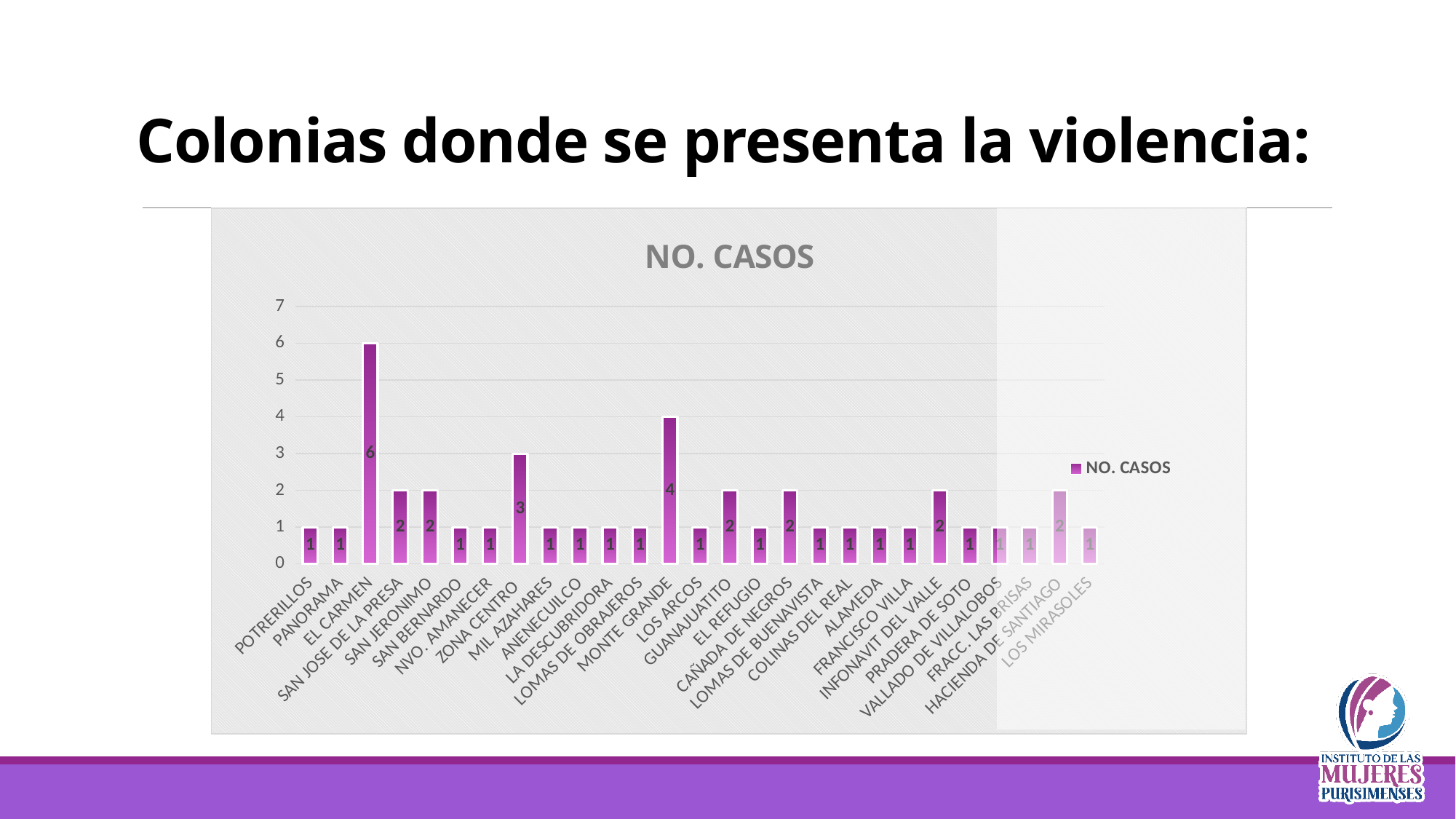
How many series does the legend list? 1 Which colonia has the highest number of cases? EL CARMEN Is the value for EL CARMEN greater or less than 5? greater What type of chart is shown on the slide? bar chart What is the value for HACIENDA DE SANTIAGO? 2 What is the title of the chart? NO. CASOS What is the value for ZONA CENTRO? 3 How many colonias (categories) are shown on the x axis? 27 What is the value for EL CARMEN? 6 What is the difference between the values for EL CARMEN and MONTE GRANDE? 2 Which has a larger value, ZONA CENTRO or SAN JERONIMO? ZONA CENTRO What is the value for MONTE GRANDE? 4